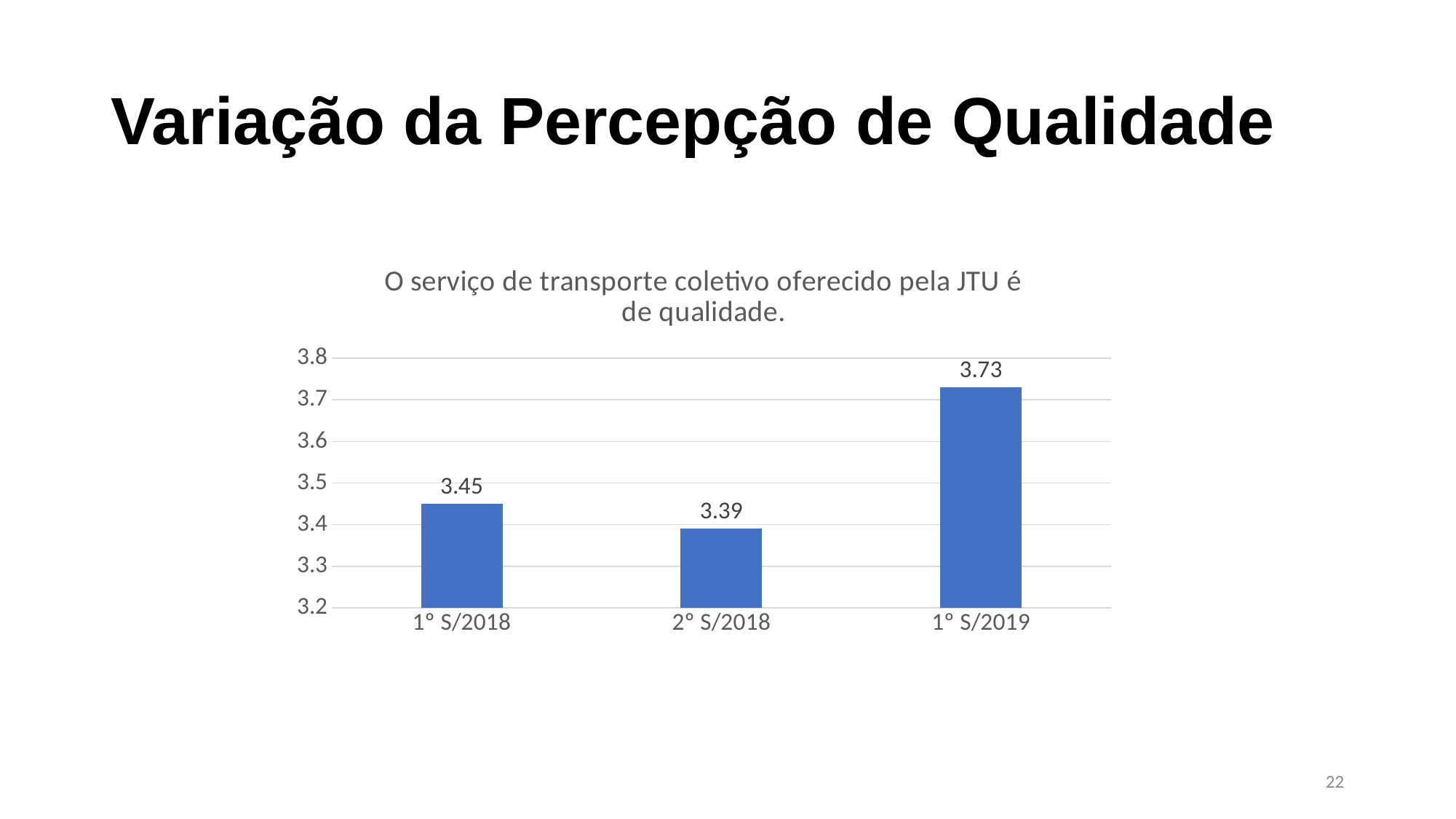
Which is larger, the value for 1° S/2018 or the value for 2° S/2018? 1° S/2018 Is the value for 1° S/2019 greater or less than 3.7? greater What is the difference between the values for 1° S/2019 and 2° S/2018? 0.34 What kind of chart is shown on the slide? bar chart How many periods are shown on the chart? 3 What is the value for 1° S/2019? 3.73 What is the title of the chart? O serviço de transporte coletivo oferecido pela JTU é de qualidade. Which period has the lowest value? 2° S/2018 What is the value for 1° S/2018? 3.45 Which period has the highest value? 1° S/2019 What is the difference between the values for 1° S/2018 and 2° S/2018? 0.06 What is the value for 2° S/2018? 3.39